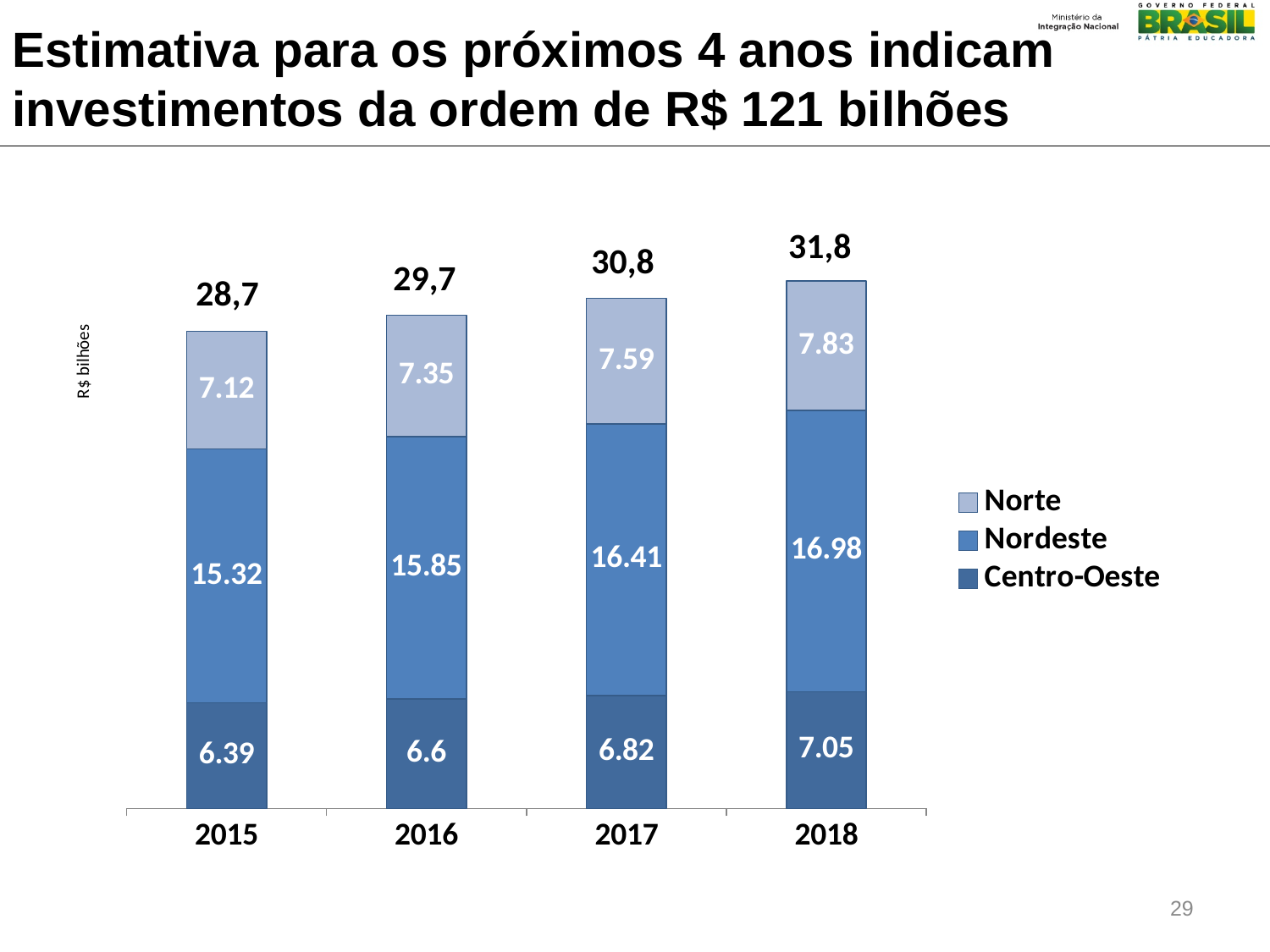
What is the value for Centro-Oeste in 2018? 7.05 How many series does the legend list? 3 Which year has the highest total investment? 2018 What kind of chart is shown on the slide? Stacked bar chart Which year has the lowest value for Centro-Oeste? 2015 What is the difference between the Nordeste values for 2018 and 2015? 1.66 What is the value for Nordeste in 2017? 16.41 What is the value for Norte in 2015? 7.12 Do the total values rise or fall from 2015 to 2018? Rise Which is larger in 2016: the value for Norte or the value for Centro-Oeste? Norte What is the total shown above the stacked bar for 2016? 29,7 How many years are shown on the x axis? 4